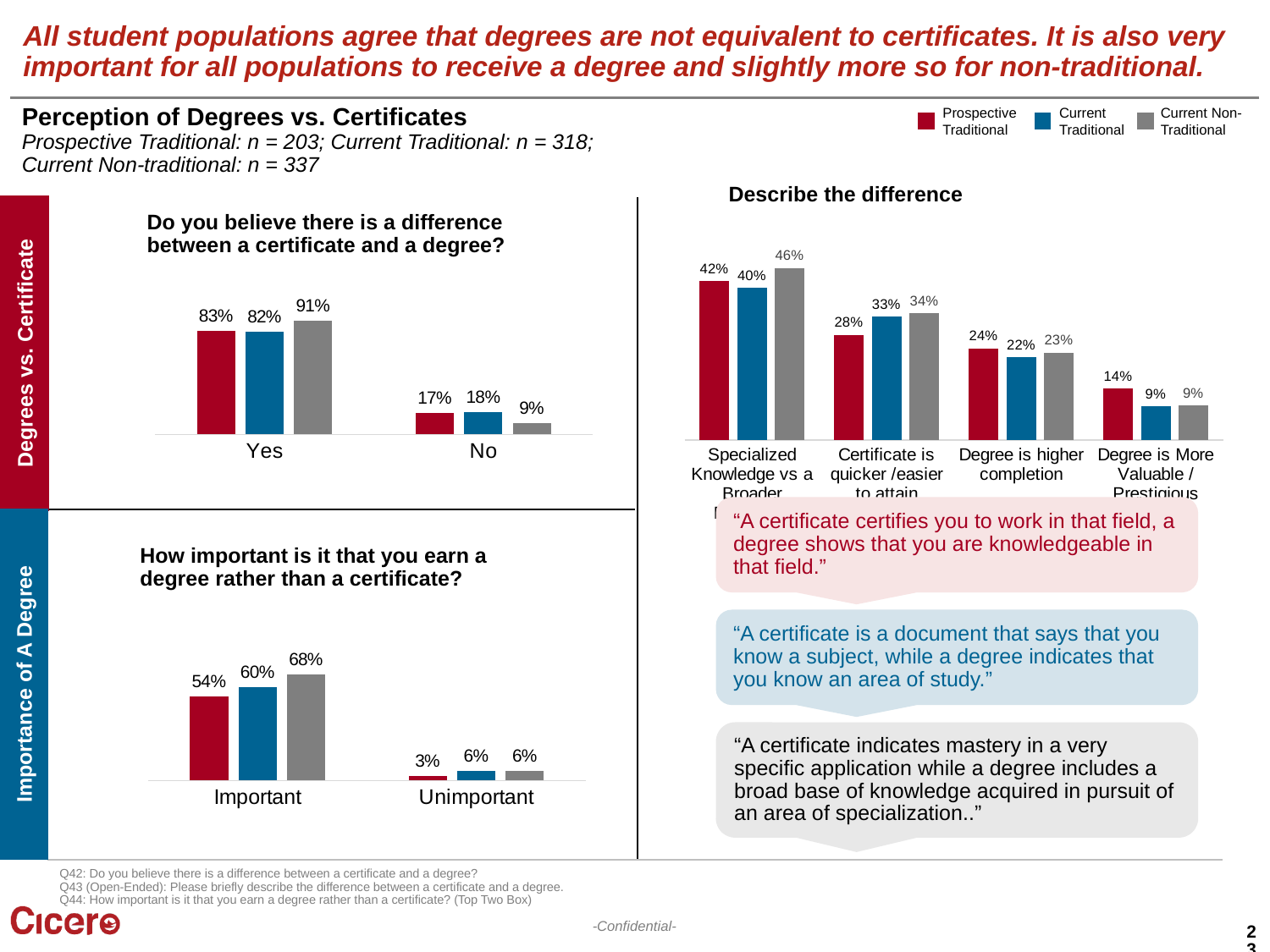
In the chart 'Do you believe there is a difference between a certificate and a degree?', what percentage of Current Non-Traditional students answered Yes? 91% What type of chart is 'Describe the difference'? Bar chart How many series does the legend at the top right of the slide list? 3 In the chart 'How important is it that you earn a degree rather than a certificate?', what percentage of Prospective Traditional students said Unimportant? 3% In the chart 'How important is it that you earn a degree rather than a certificate?', which population has the highest value for Important? Current Non-Traditional In the chart 'Describe the difference', what percentage of Current Traditional students said 'Certificate is quicker/easier to attain'? 33% In the chart 'Describe the difference', which category has the lowest values across all three populations? Degree is More Valuable / Prestigious In the chart 'Describe the difference', how many categories are shown on the x axis? 4 In the chart 'Do you believe there is a difference between a certificate and a degree?', what percentage of Prospective Traditional students answered No? 17% In the chart 'Do you believe there is a difference between a certificate and a degree?', what is the difference between the Yes and No values for Current Traditional students? 64% In the chart 'Describe the difference', what is the difference between the Current Non-Traditional and Prospective Traditional values for 'Specialized Knowledge vs a Broader'? 4% In the chart 'How important is it that you earn a degree rather than a certificate?', what percentage of Current Traditional students said Important? 60%